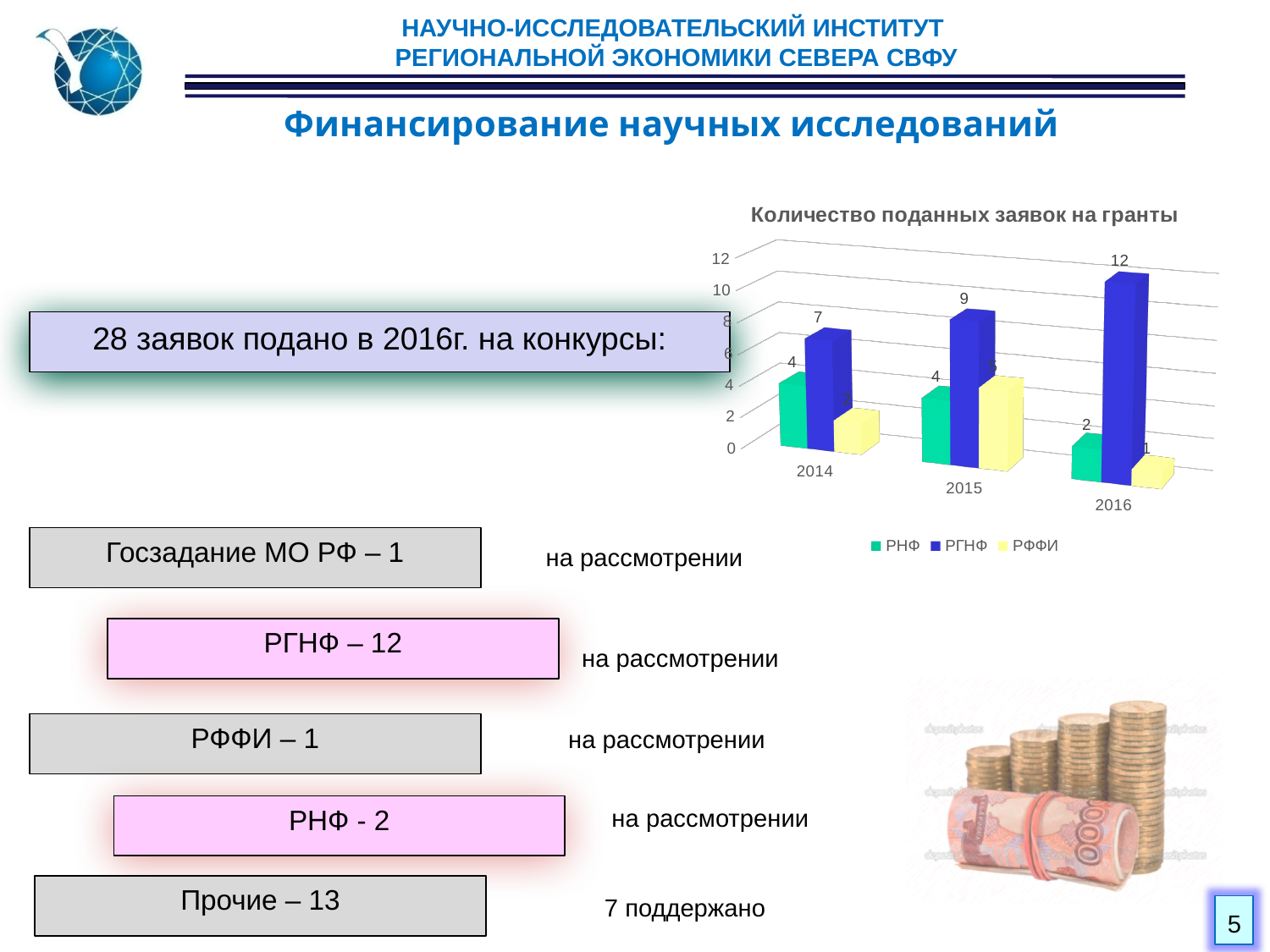
What is the value for РГНФ in 2015? 9 What is the value for РНФ in 2014? 4 What is the title of the chart on the slide? Количество поданных заявок на гранты Which is larger in 2015: the РНФ value or the РГНФ value? РГНФ Does the РГНФ value rise or fall from 2014 to 2016? rise In which year is the РГНФ value highest? 2016 How many series does the chart legend list? 3 How many years are shown on the x axis of the chart? 3 What is the value for РГНФ in 2016? 12 What type of chart is shown on the slide? bar chart What is the difference between the РГНФ values for 2016 and 2014? 5 In which year is the РНФ value lowest? 2016